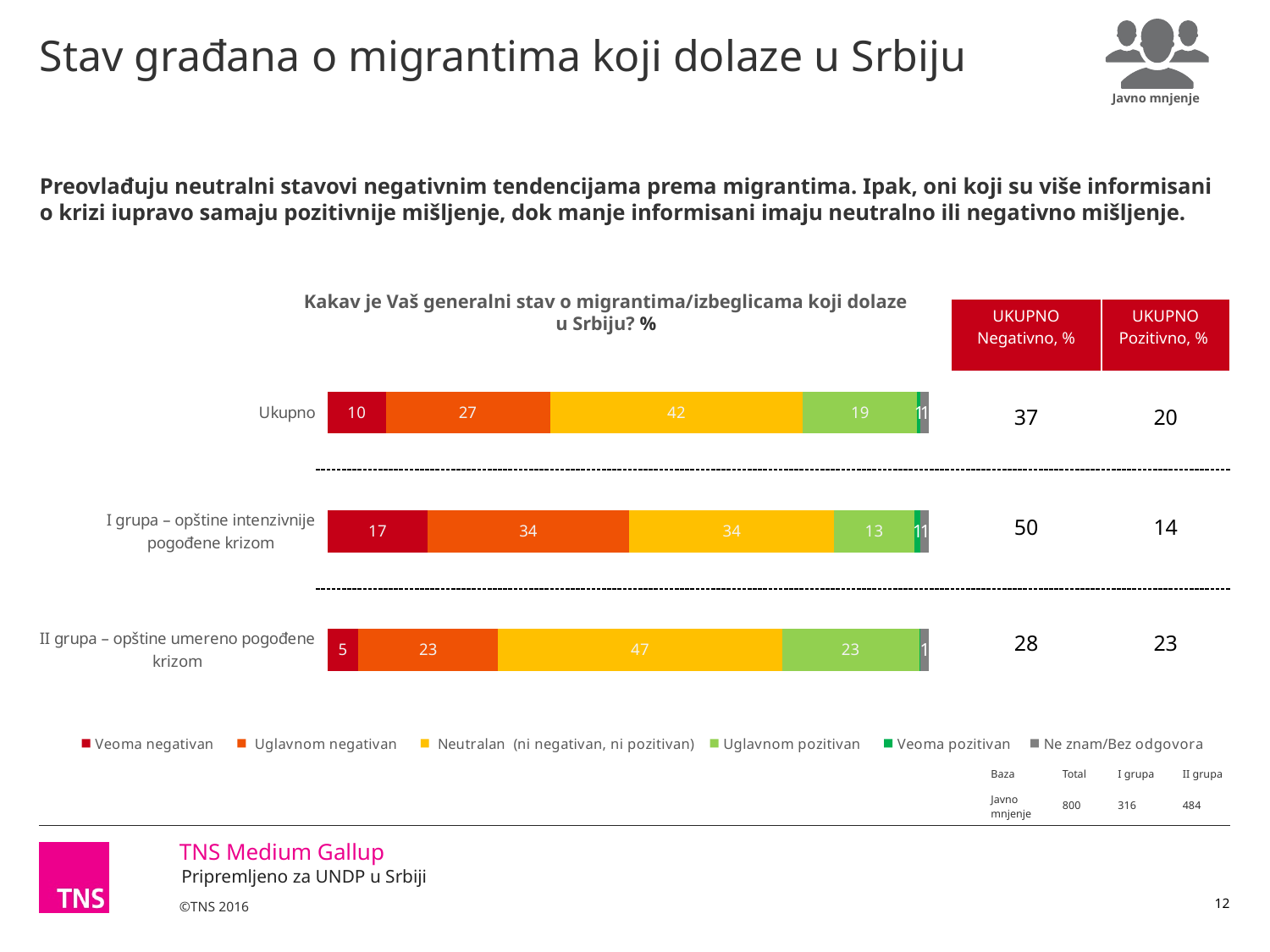
Is the Uglavnom pozitivan value larger for Ukupno or for I grupa – opštine intenzivnije pogođene krizom? Ukupno What colour represents the Neutralan (ni negativan, ni pozitivan) series in the chart? Yellow What is the difference between the Uglavnom negativan values for I grupa and II grupa? 11 Which category has the highest Neutralan (ni negativan, ni pozitivan) value? II grupa – opštine umereno pogođene krizom What is the Veoma negativan value for I grupa – opštine intenzivnije pogođene krizom? 17 What is the Uglavnom pozitivan value for II grupa – opštine umereno pogođene krizom? 23 How many categories (rows) does the bar chart show? 3 What type of chart is shown on the slide? Stacked bar chart What is the Neutralan (ni negativan, ni pozitivan) value for Ukupno? 42 Which category has the lowest Veoma negativan value? II grupa – opštine umereno pogođene krizom In the UKUPNO Negativno, % column, what is the value for I grupa – opštine intenzivnije pogođene krizom? 50 How many series does the chart legend list? 6